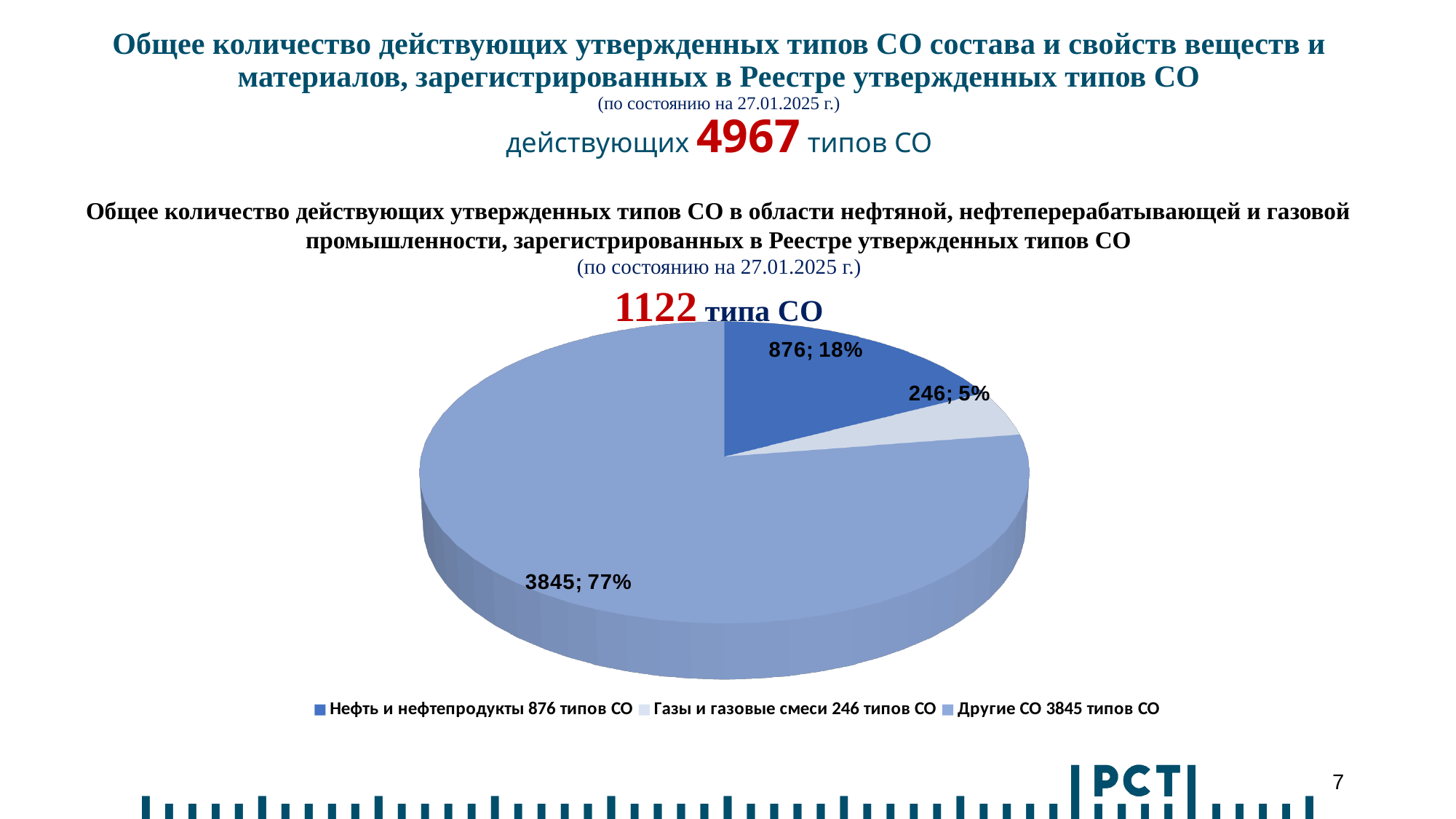
How many slices does the pie chart have? 3 Which slice of the pie chart is the largest? Другие СО What percentage share of the pie does 'Другие СО' have? 77% What value is shown for the slice 'Нефть и нефтепродукты'? 876 What is the difference between the values for 'Нефть и нефтепродукты' and 'Газы и газовые смеси'? 630 What value is shown for the slice 'Другие СО'? 3845 How many entries does the legend of the pie chart list? 3 What value is shown for the slice 'Газы и газовые смеси'? 246 Which slice of the pie chart is the smallest? Газы и газовые смеси What kind of chart is shown on the slide? pie chart Which is larger, the value for 'Нефть и нефтепродукты' or the value for 'Газы и газовые смеси'? Нефть и нефтепродукты What percentage share of the pie does 'Нефть и нефтепродукты' have? 18%